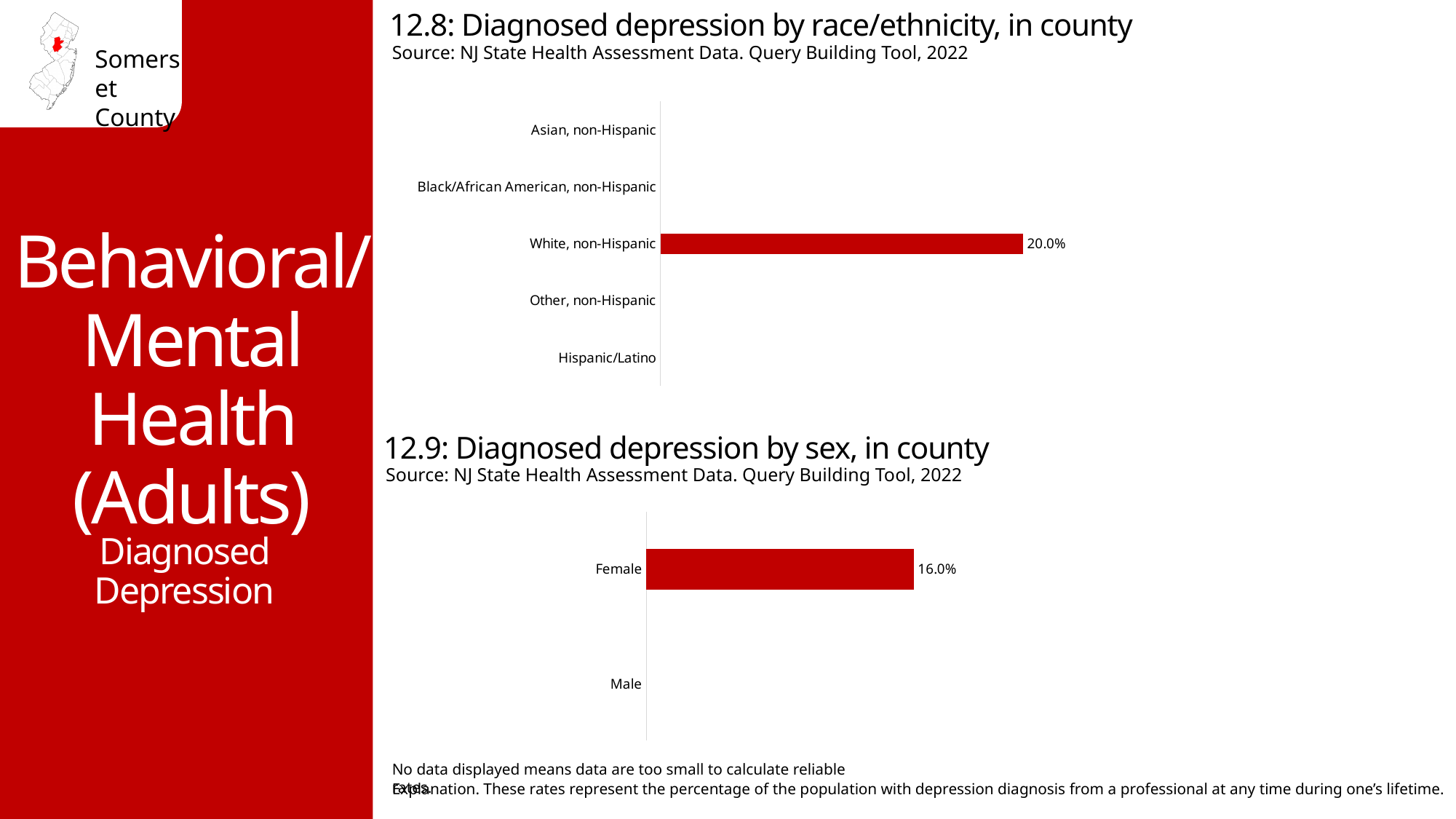
Is the value for White, non-Hispanic in the chart '12.8: Diagnosed depression by race/ethnicity, in county' larger or smaller than the value for Female in the chart '12.9: Diagnosed depression by sex, in county'? Larger How many categories are listed on the y axis of the chart '12.9: Diagnosed depression by sex, in county'? 2 In the chart '12.8: Diagnosed depression by race/ethnicity, in county', which category has the highest value shown? White, non-Hispanic In the chart '12.8: Diagnosed depression by race/ethnicity, in county', what is the value for White, non-Hispanic? 20.0% How many race/ethnicity categories are listed on the y axis of the chart '12.8: Diagnosed depression by race/ethnicity, in county'? 5 In the chart '12.8: Diagnosed depression by race/ethnicity, in county', which category is the only one with a bar displayed? White, non-Hispanic What kind of chart is '12.9: Diagnosed depression by sex, in county'? Bar chart What kind of chart is '12.8: Diagnosed depression by race/ethnicity, in county'? Bar chart In the chart '12.9: Diagnosed depression by sex, in county', which category has a bar displayed? Female In the chart '12.9: Diagnosed depression by sex, in county', what is the value for Female? 16.0% What source is cited for the chart '12.9: Diagnosed depression by sex, in county'? NJ State Health Assessment Data. Query Building Tool, 2022